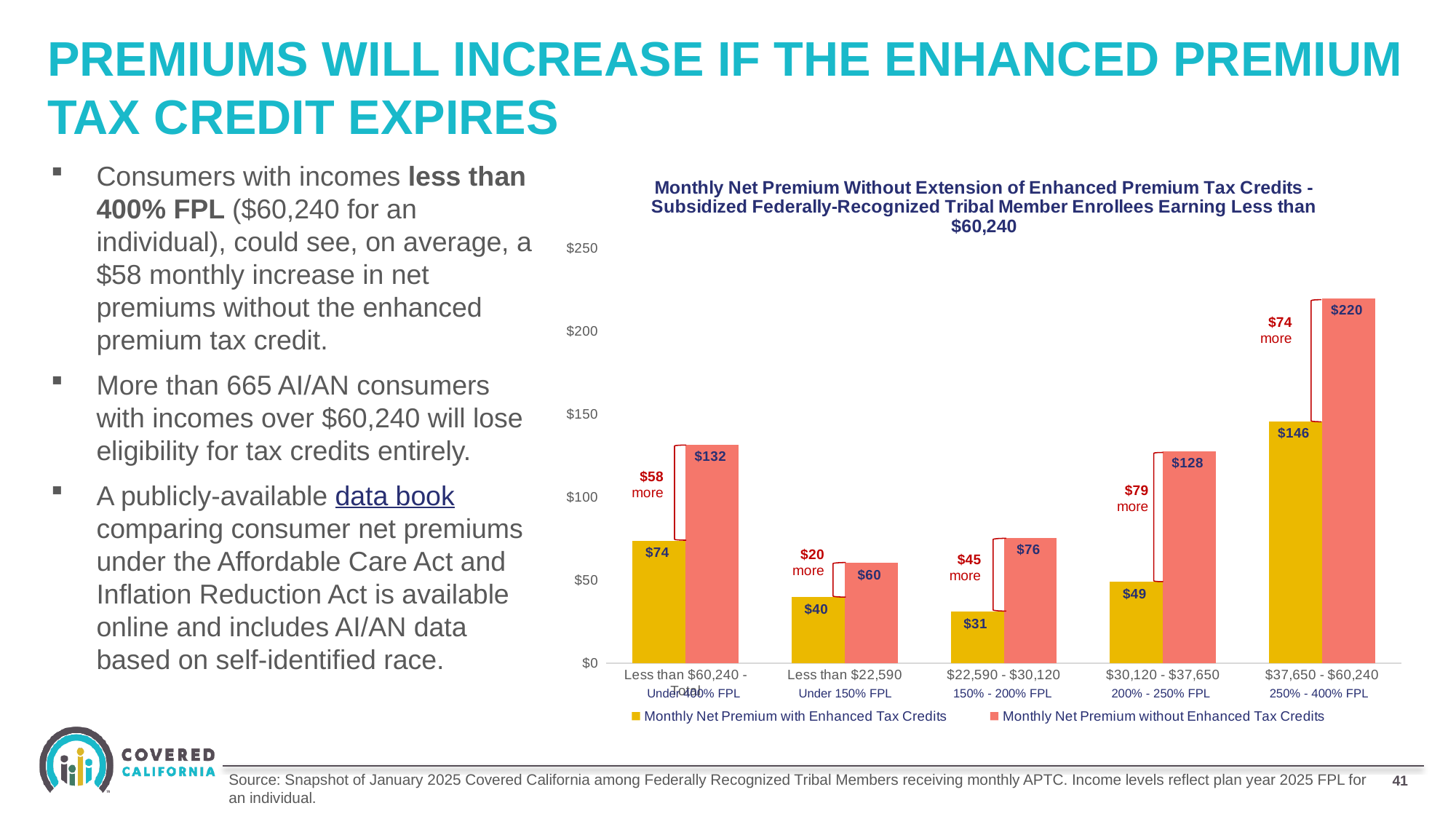
What is the Monthly Net Premium without Enhanced Tax Credits for the $37,650 - $60,240 (250% - 400% FPL) income group? $220 Which is larger: the premium without Enhanced Tax Credits for the Less than $22,590 group or for the $22,590 - $30,120 group? $22,590 - $30,120 What is the Monthly Net Premium with Enhanced Tax Credits for the $22,590 - $30,120 (150% - 200% FPL) income group? $31 How much more is the Monthly Net Premium without Enhanced Tax Credits than with them for the $30,120 - $37,650 (200% - 250% FPL) group? $79 Which income group has the highest Monthly Net Premium without Enhanced Tax Credits? $37,650 - $60,240 (250% - 400% FPL) Is the Monthly Net Premium without Enhanced Tax Credits for the $30,120 - $37,650 group greater or less than $100? greater What type of chart is shown on the slide? Bar chart How many series does the chart's legend list? 2 What is the Monthly Net Premium with Enhanced Tax Credits for the Less than $22,590 (Under 150% FPL) group? $40 How many income groups are shown on the x axis of the chart? 5 Which income group has the lowest Monthly Net Premium with Enhanced Tax Credits? $22,590 - $30,120 (150% - 200% FPL) What is the difference between the premium without and with Enhanced Tax Credits for the Less than $60,240 (Under 400% FPL) group? $58